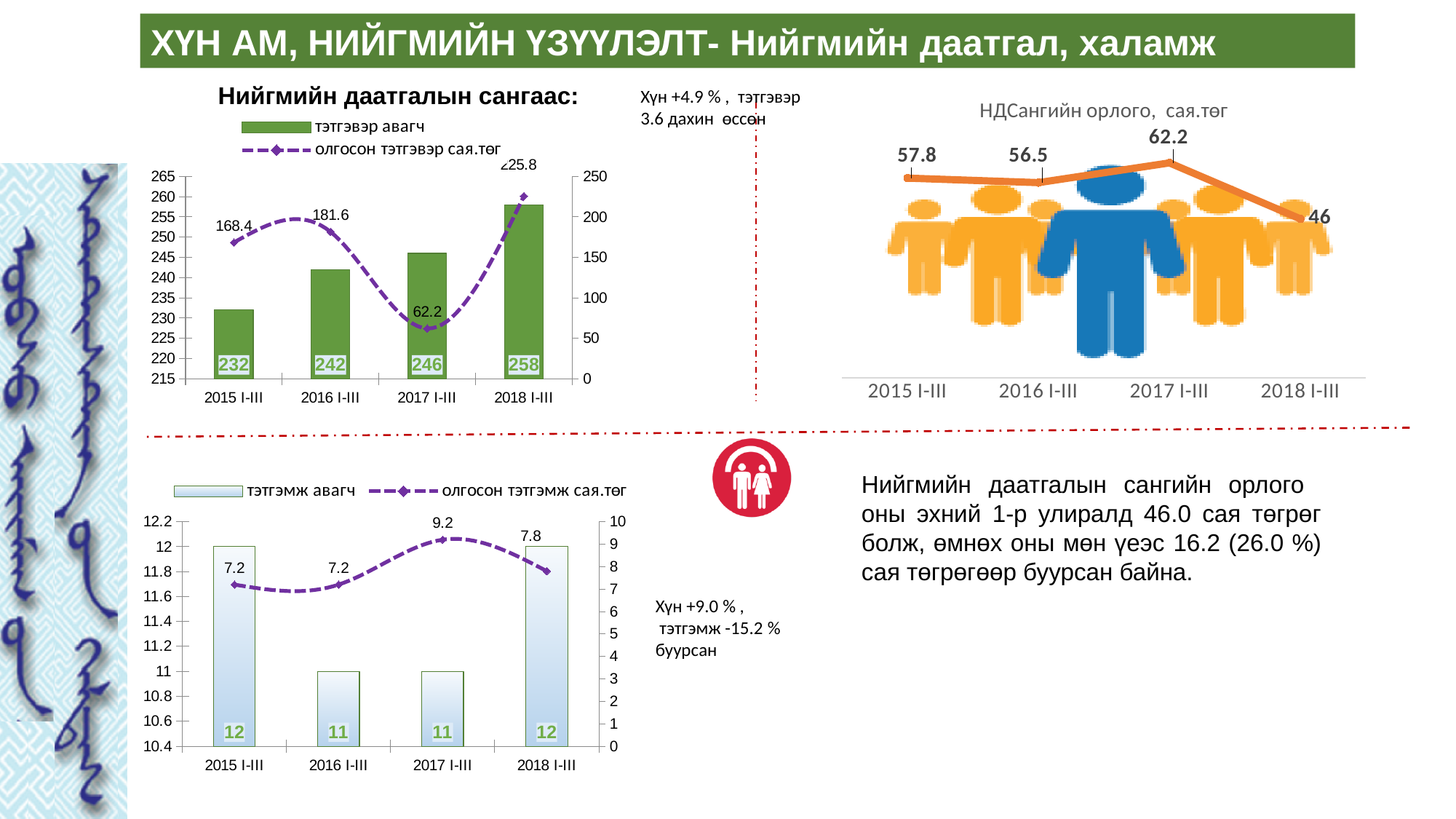
In the top-left chart titled 'Нийгмийн даатгалын сангаас:', do the 'тэтгэвэр авагч' bars rise or fall from 2015 I-III to 2018 I-III? rise In the bottom-left chart, how many periods are shown on the x axis? 4 In the top-left chart titled 'Нийгмийн даатгалын сангаас:', what is the difference between the 'тэтгэвэр авагч' values for 2018 I-III and 2015 I-III? 26 In the top-left chart titled 'Нийгмийн даатгалын сангаас:', how many series does the legend list? 2 In the top-left chart titled 'Нийгмийн даатгалын сангаас:', which period has the lowest 'олгосон тэтгэвэр сая.төг' value? 2017 I-III In the top-right chart titled 'НДСангийн орлого, сая.төг', which period has the highest value? 2017 I-III In the top-left chart titled 'Нийгмийн даатгалын сангаас:', what is the value of 'тэтгэвэр авагч' for 2018 I-III? 258 In the top-left chart titled 'Нийгмийн даатгалын сангаас:', what is the value of 'олгосон тэтгэвэр сая.төг' for 2017 I-III? 62.2 In the top-right chart titled 'НДСангийн орлого, сая.төг', what is the difference between the values for 2017 I-III and 2018 I-III? 16.2 In the bottom-left chart, is the 'тэтгэмж авагч' value for 2016 I-III larger or smaller than the value for 2018 I-III? smaller In the top-right chart titled 'НДСангийн орлого, сая.төг', what is the value for 2016 I-III? 56.5 In the bottom-left chart, what is the value of 'олгосон тэтгэмж сая.төг' for 2017 I-III? 9.2